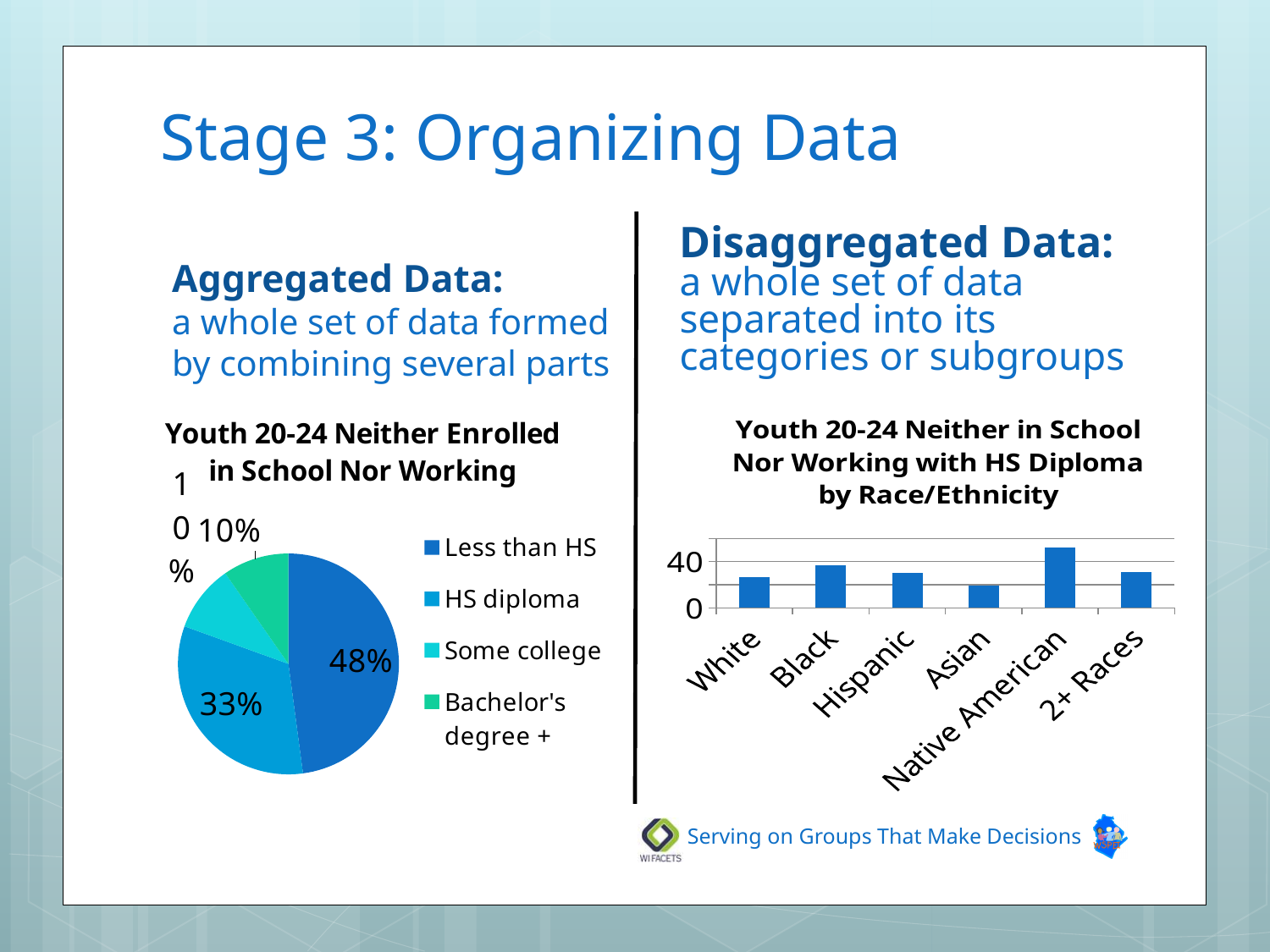
On the pie chart 'Youth 20-24 Neither Enrolled in School Nor Working', how many percentage points larger is the Less than HS slice than the HS diploma slice? 15 On the pie chart 'Youth 20-24 Neither Enrolled in School Nor Working', how many entries does the legend list? 4 On the bar chart 'Youth 20-24 Neither in School Nor Working with HS Diploma by Race/Ethnicity', is the value for Native American greater or less than 40? greater On the pie chart 'Youth 20-24 Neither Enrolled in School Nor Working', what share is labelled for the Less than HS slice? 48% On the bar chart 'Youth 20-24 Neither in School Nor Working with HS Diploma by Race/Ethnicity', how many race/ethnicity categories are shown? 6 On the bar chart 'Youth 20-24 Neither in School Nor Working with HS Diploma by Race/Ethnicity', which category has the highest bar? Native American On the pie chart 'Youth 20-24 Neither Enrolled in School Nor Working', what share is labelled for the HS diploma slice? 33% What kind of chart is the right chart, 'Youth 20-24 Neither in School Nor Working with HS Diploma by Race/Ethnicity'? Bar chart On the pie chart 'Youth 20-24 Neither Enrolled in School Nor Working', which category has the largest slice? Less than HS On the bar chart 'Youth 20-24 Neither in School Nor Working with HS Diploma by Race/Ethnicity', which category has the lowest bar? Asian On the bar chart 'Youth 20-24 Neither in School Nor Working with HS Diploma by Race/Ethnicity', which is larger, the value for Black or the value for Asian? Black What kind of chart is the left chart, 'Youth 20-24 Neither Enrolled in School Nor Working'? Pie chart